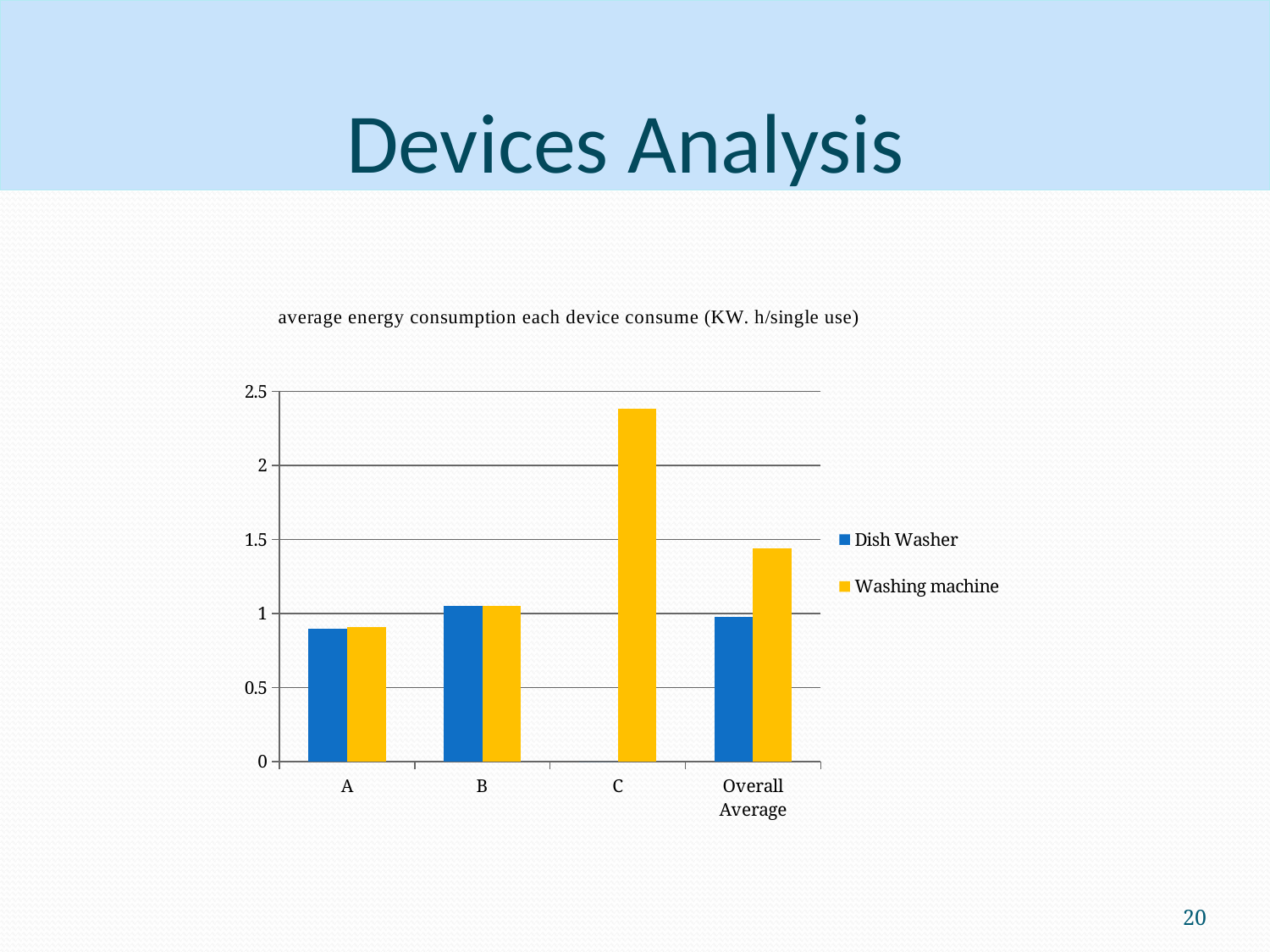
For Overall Average, which is larger: Dish Washer or Washing machine? Washing machine Which category has the highest Washing machine value? C Which category has the lowest Washing machine value? A Is the Washing machine value for C greater or less than 2? greater Is the Dish Washer value for A greater or less than 1? less What kind of chart is shown on the slide? bar chart What is the title of the chart? average energy consumption each device consume (KW. h/single use) How many categories are shown on the x axis? 4 Is the Washing machine value for Overall Average greater or less than 1? greater Which category has no Dish Washer bar? C How many series does the legend list? 2